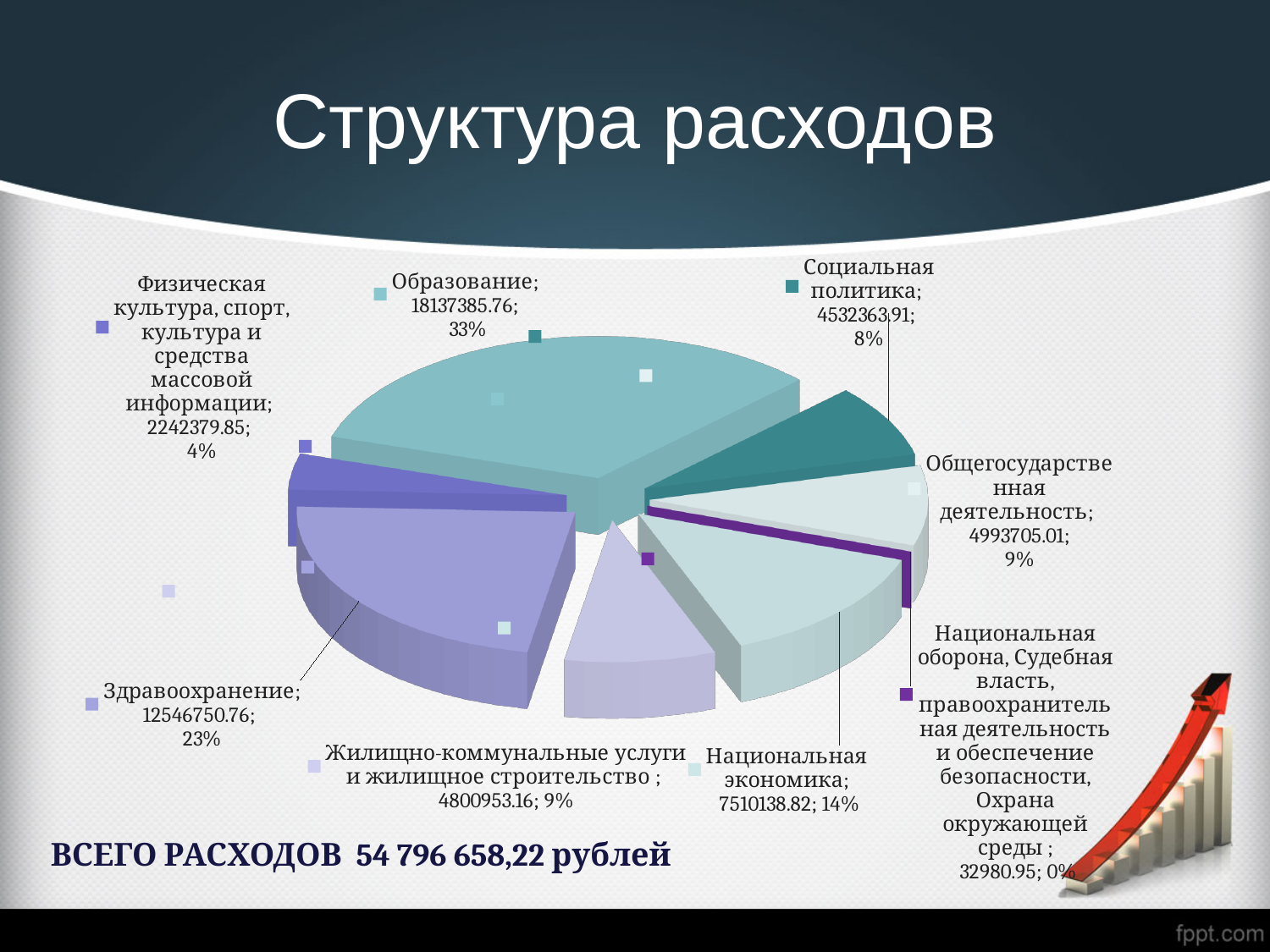
What is the value shown for Образование? 18137385.76 What kind of chart is shown on the slide? Pie chart What total expenditure is stated on the slide? 54 796 658,22 рублей Which is larger: the value for Общегосударственная деятельность or the value for Социальная политика? Общегосударственная деятельность What percentage is shown for Социальная политика? 8% Which category has the largest share of the pie? Образование What share of the pie does Здравоохранение represent? 23% What is the value shown for Национальная экономика? 7510138.82 Which category has the smallest share of the pie? Национальная оборона, Судебная власть, правоохранительная деятельность и обеспечение безопасности, Охрана окружающей среды What is the difference between the percentage shares of Образование and Здравоохранение? 10% How many categories (slices) does the pie chart have? 8 What is the title of the chart on the slide? Структура расходов